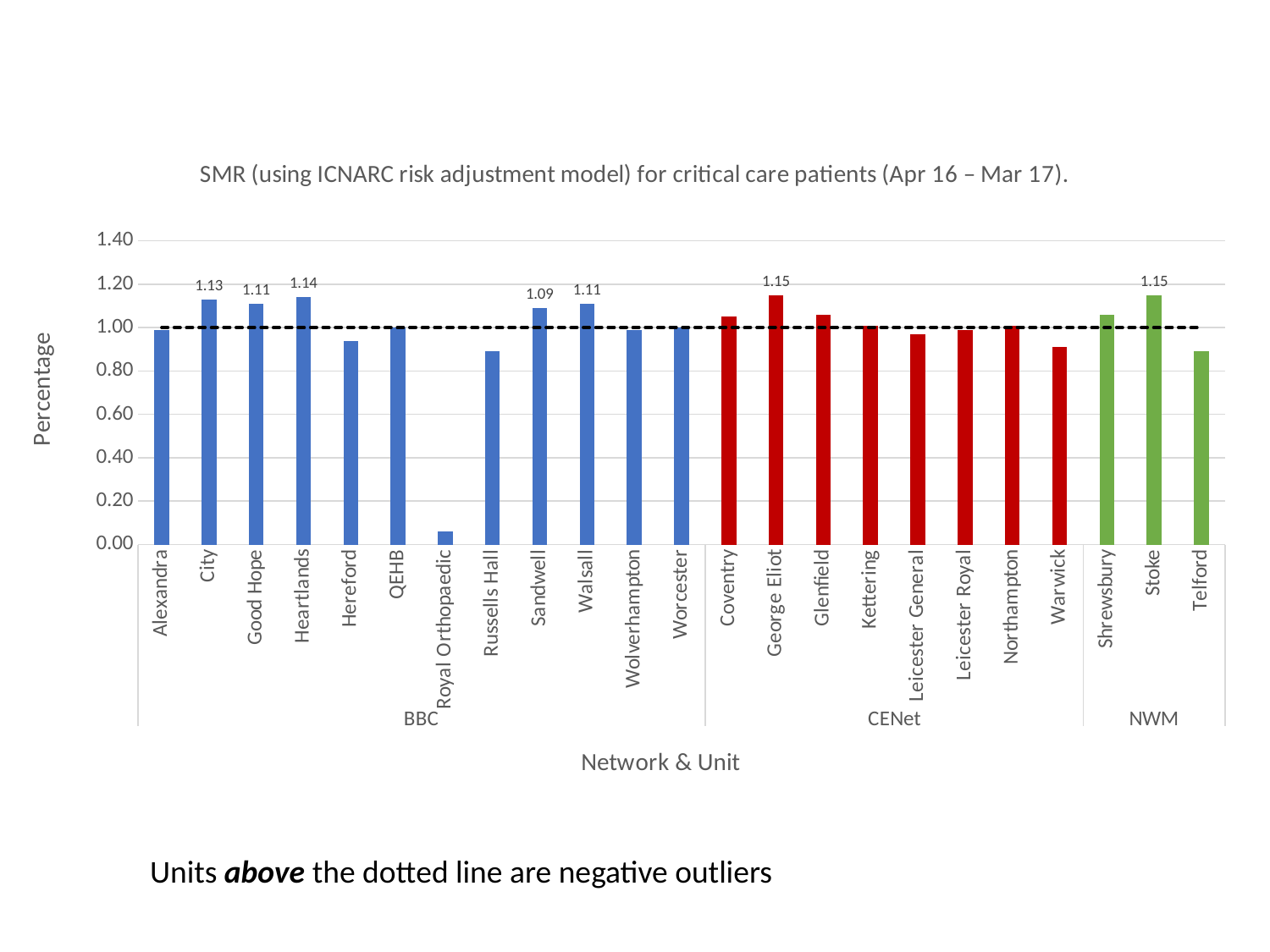
What kind of chart is shown? bar chart What is the value for Heartlands? 1.14 What is the value for George Eliot? 1.15 Is the value for Hereford greater or less than 1.00? less How many units are plotted on the chart? 23 Is the value for Royal Orthopaedic greater or less than 0.20? less Which unit has the lowest value? Royal Orthopaedic What is the label on the vertical axis? Percentage What is the value for City? 1.13 What is the value for Sandwell? 1.09 What is the difference between the values for Heartlands and Sandwell? 0.05 Which is larger, the value for Walsall or the value for Sandwell? Walsall